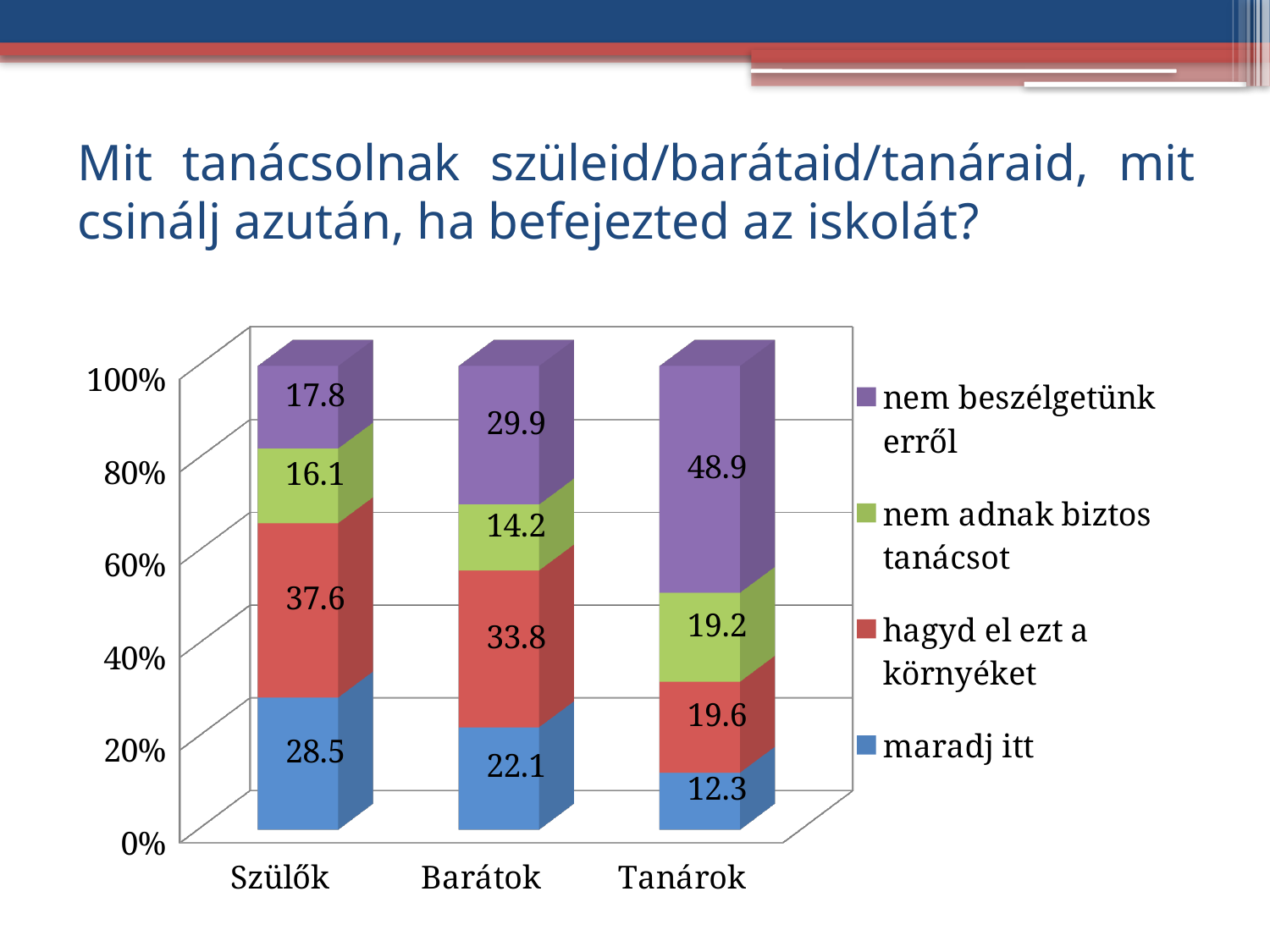
What is the value for "nem adnak biztos tanácsot" in the Tanárok bar? 19.2 What is the value for "maradj itt" in the Szülők bar? 28.5 Which category has the lowest value for "maradj itt"? Tanárok How many categories are shown on the x axis? 3 Which category has the highest value for "nem beszélgetünk erről"? Tanárok What kind of chart is shown on the slide? Stacked bar chart What is the value for "hagyd el ezt a környéket" in the Barátok bar? 33.8 What is the value for "nem beszélgetünk erről" in the Tanárok bar? 48.9 How many series does the legend list? 4 Which is larger: the "nem beszélgetünk erről" value for Barátok or for Szülők? Barátok Which colour represents "maradj itt" in the chart? Blue What is the difference between the "hagyd el ezt a környéket" values for Szülők and Tanárok? 18